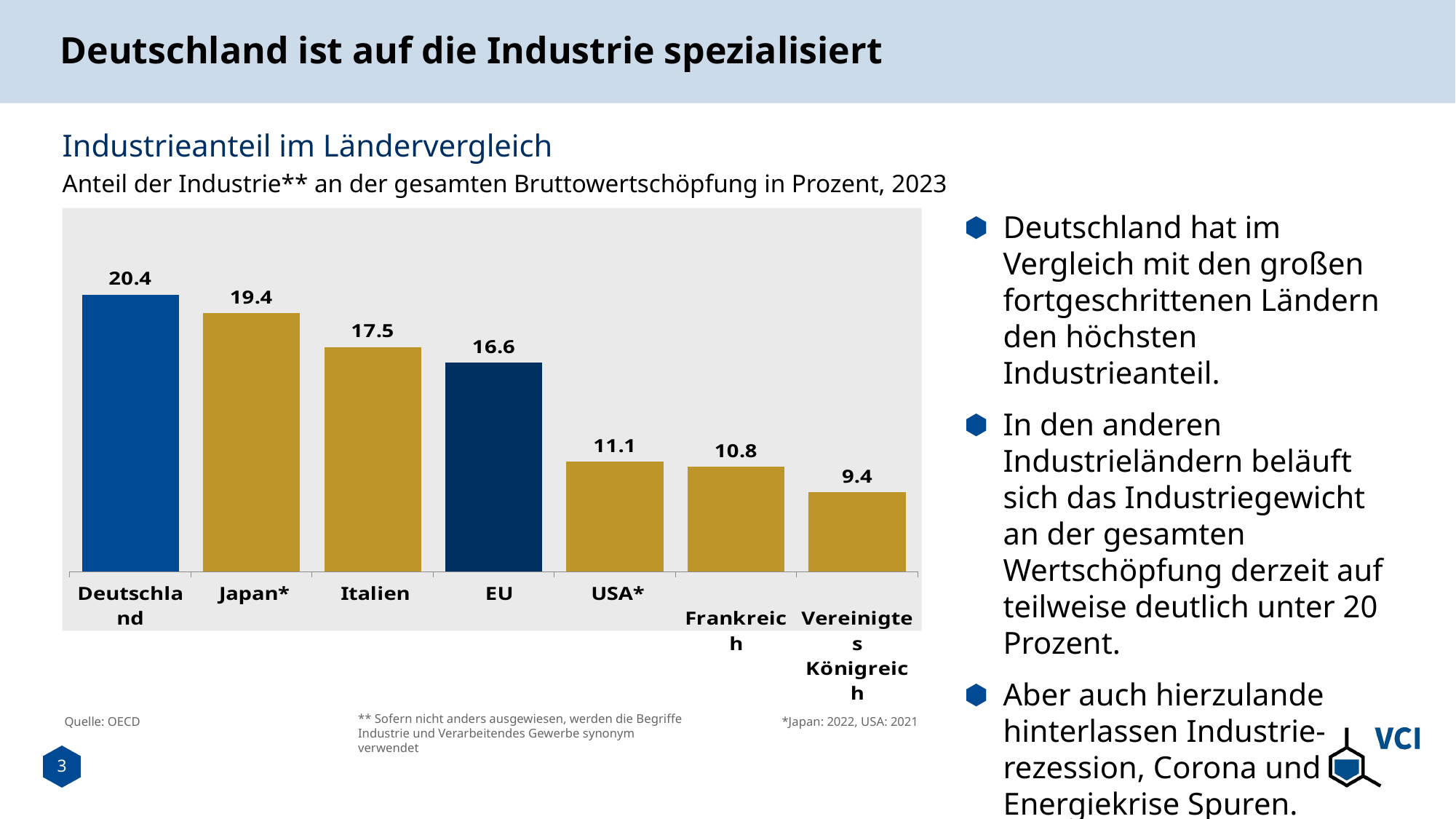
What is the title of the chart? Industrieanteil im Ländervergleich What is the value for Deutschland? 20.4 What kind of chart is shown on the slide? Bar chart Which category has the lowest value? Vereinigtes Königreich What is the difference between the values for Deutschland and Japan*? 1.0 Which category has the highest value? Deutschland How many categories are shown in the chart? 7 What is the value for Italien? 17.5 Do the values rise or fall from left to right along the x axis? Fall What is the difference between the values for EU and USA*? 5.5 What is the value for Frankreich? 10.8 Which is larger, the value for Italien or the value for EU? Italien